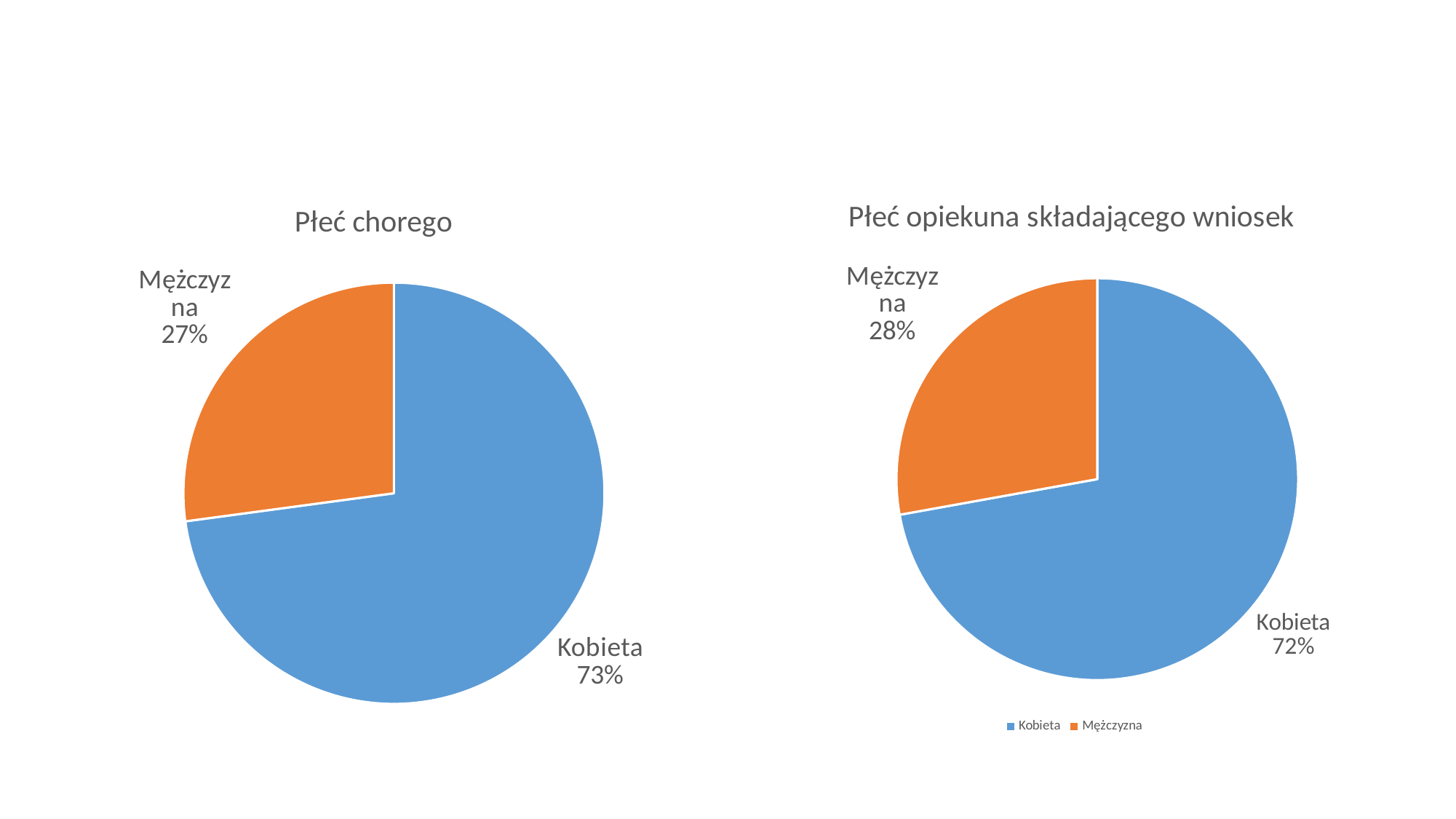
In the 'Płeć chorego' chart, what share of the pie is Kobieta? 73% What kind of chart is the 'Płeć chorego' chart? Pie chart In the 'Płeć chorego' chart, what is the difference in percentage points between Kobieta and Mężczyzna? 46 Which is larger: the Mężczyzna share in the 'Płeć chorego' chart or the Mężczyzna share in the 'Płeć opiekuna składającego wniosek' chart? Płeć opiekuna składającego wniosek In the 'Płeć opiekuna składającego wniosek' chart, what is the difference in percentage points between Kobieta and Mężczyzna? 44 How many slices does the 'Płeć opiekuna składającego wniosek' chart have? 2 In the 'Płeć chorego' chart, which category has the largest slice? Kobieta What colour is the Kobieta slice in the 'Płeć opiekuna składającego wniosek' chart? Blue In the 'Płeć opiekuna składającego wniosek' chart, what share of the pie is Mężczyzna? 28% In the 'Płeć opiekuna składającego wniosek' chart, what share of the pie is Kobieta? 72% In the 'Płeć opiekuna składającego wniosek' chart, which category has the smallest slice? Mężczyzna